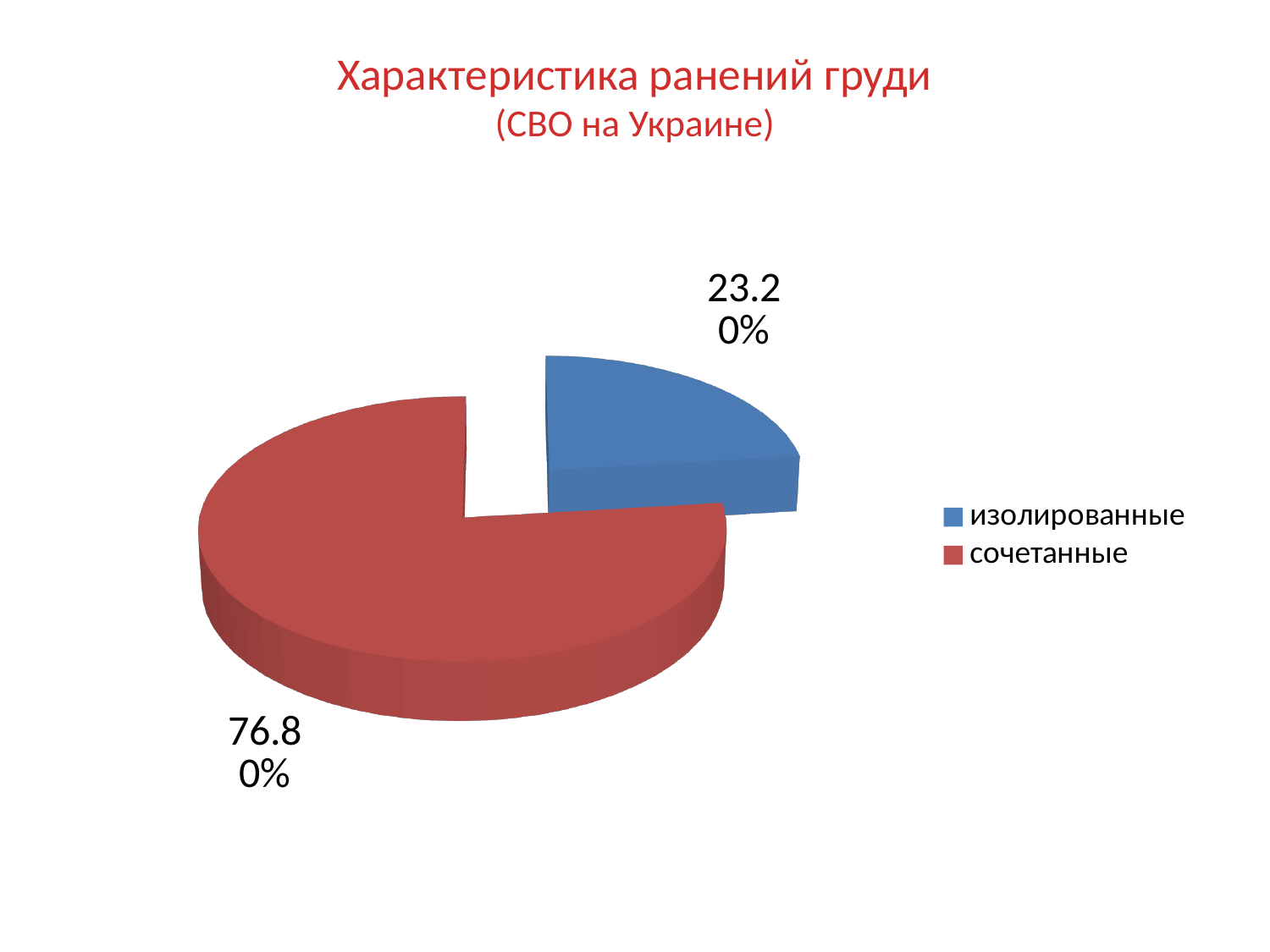
What kind of chart is shown on the slide? Pie chart What is the difference between the values for сочетанные and изолированные? 53.60% Which category has the largest slice of the pie? сочетанные How many categories does the pie chart show? 2 Which is larger, the value for изолированные or the value for сочетанные? сочетанные What value is shown for the сочетанные slice? 76.80% What value is shown for the изолированные slice? 23.20% Which category has the smallest slice of the pie? изолированные What colour is the сочетанные slice? Red What is the title of the chart? Характеристика ранений груди (СВО на Украине)